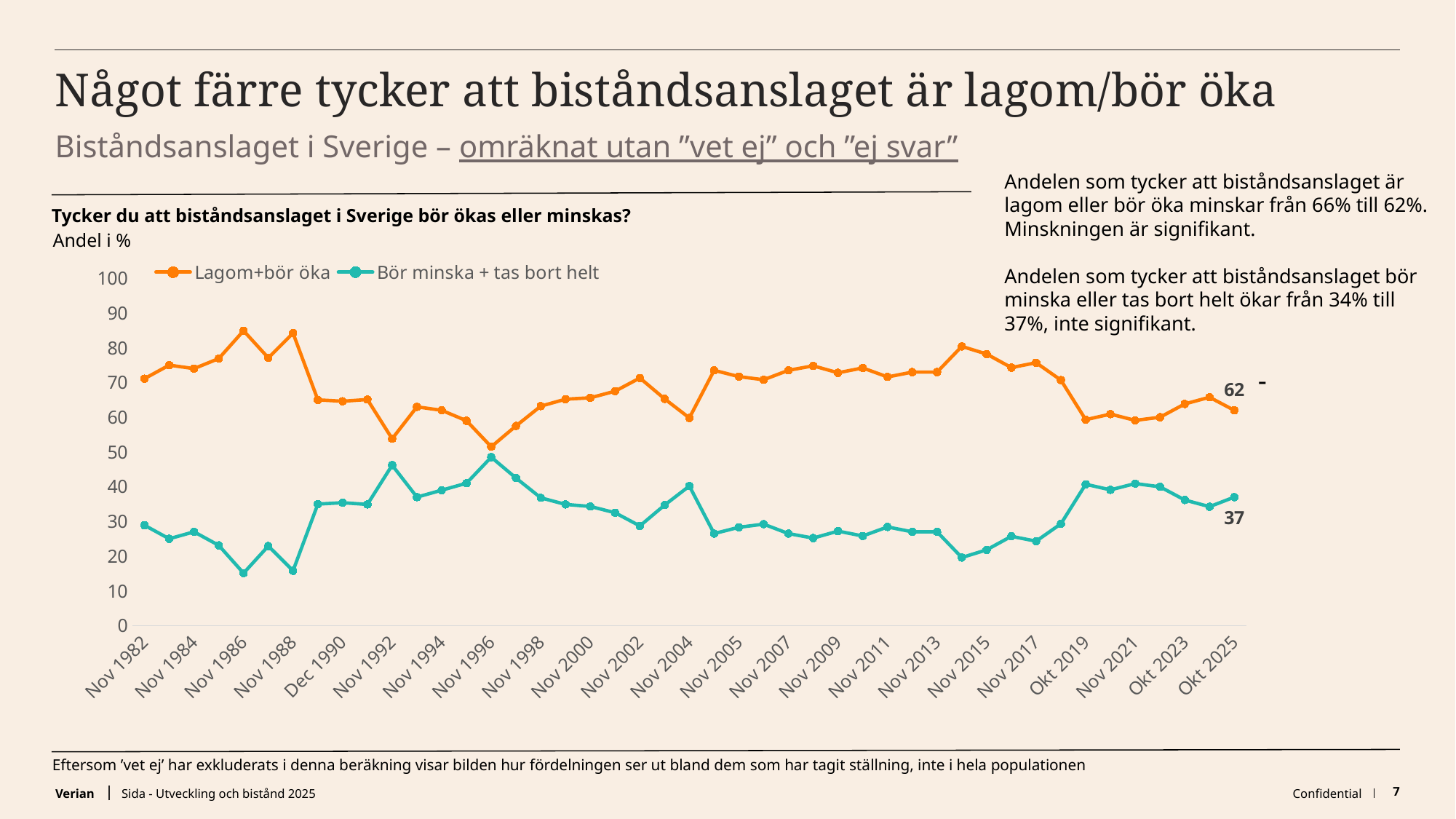
Is the value for 'Bör minska + tas bort helt' at Nov 1986 greater or less than 20? less How many series does the legend list? 2 What is the value for the 'Lagom+bör öka' series at Okt 2025? 62 What kind of chart is shown on the slide? Line chart Is the value for 'Lagom+bör öka' at Nov 2004 greater or less than 70? less What is the difference between the 'Lagom+bör öka' and 'Bör minska + tas bort helt' values at Okt 2025? 25 Is the value for 'Lagom+bör öka' at Nov 1986 greater or less than 80? greater What are the two legend entries of the chart? Lagom+bör öka; Bör minska + tas bort helt Between Nov 2017 and Okt 2019, does the 'Lagom+bör öka' series rise or fall? fall At Okt 2025, which series has the larger value, 'Lagom+bör öka' or 'Bör minska + tas bort helt'? Lagom+bör öka What is the value for the 'Bör minska + tas bort helt' series at Okt 2025? 37 What survey question is shown as the chart's heading? Tycker du att biståndsanslaget i Sverige bör ökas eller minskas?